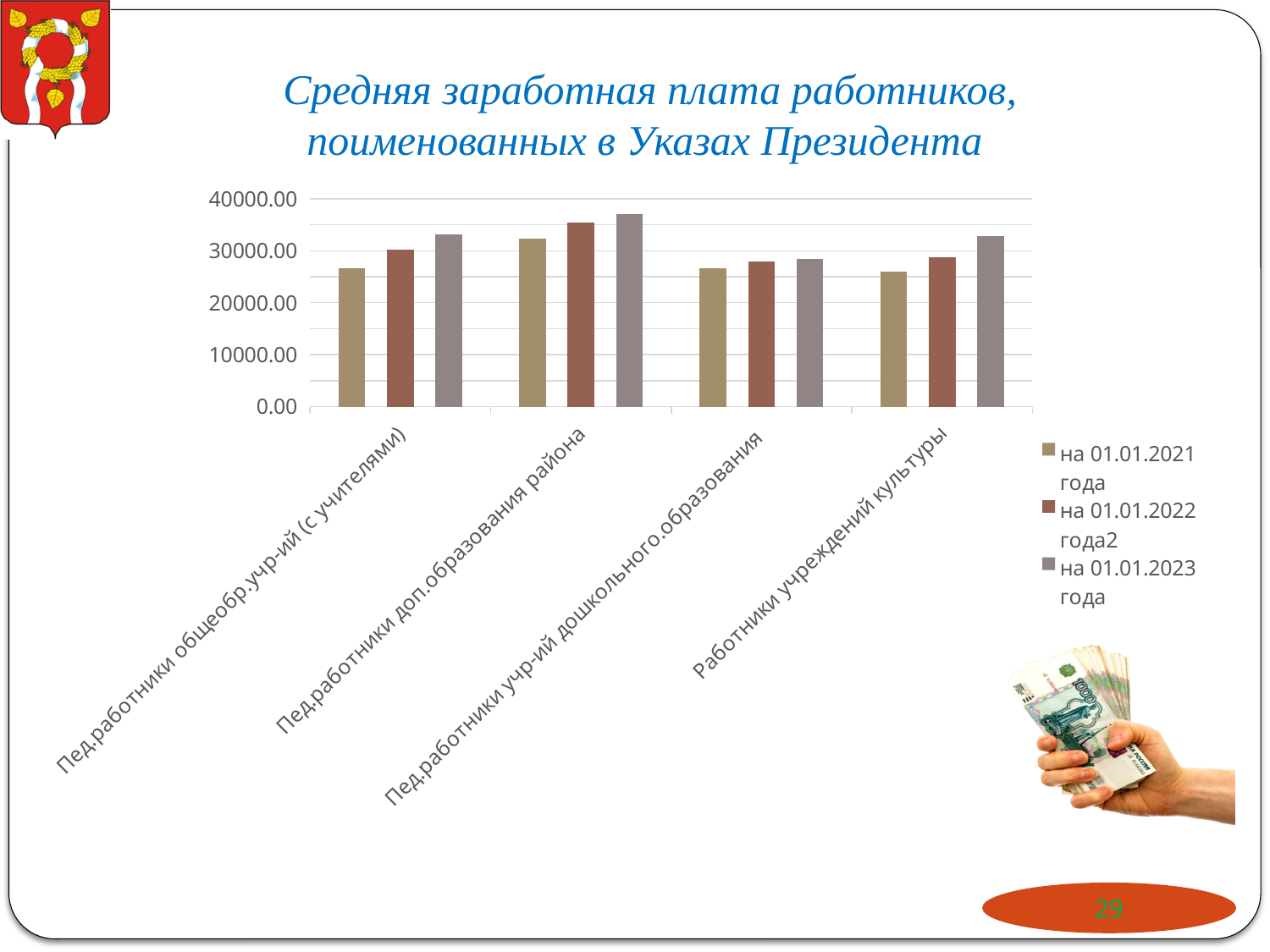
Which category has the lowest value for the series на 01.01.2023 года? Пед.работники учр-ий дошкольного.образования Is the value for Пед.работники общеобр.учр-ий (с учителями) on 01.01.2023 greater or less than 30000.00? greater Is the value for Пед.работники учр-ий дошкольного.образования on 01.01.2021 greater or less than 30000.00? less Within each category, do the values rise or fall from 01.01.2021 to 01.01.2023? rise What is the title of the chart on the slide? Средняя заработная плата работников, поименованных в Указах Президента Is the value for Работники учреждений культуры on 01.01.2021 greater or less than 30000.00? less How many categories are shown on the x axis of the chart? 4 Which category has the highest value for the series на 01.01.2023 года? Пед.работники доп.образования района How many series does the legend list? 3 For the series на 01.01.2022 года2, which is larger: Пед.работники доп.образования района or Пед.работники учр-ий дошкольного.образования? Пед.работники доп.образования района What kind of chart is shown on the slide? bar chart